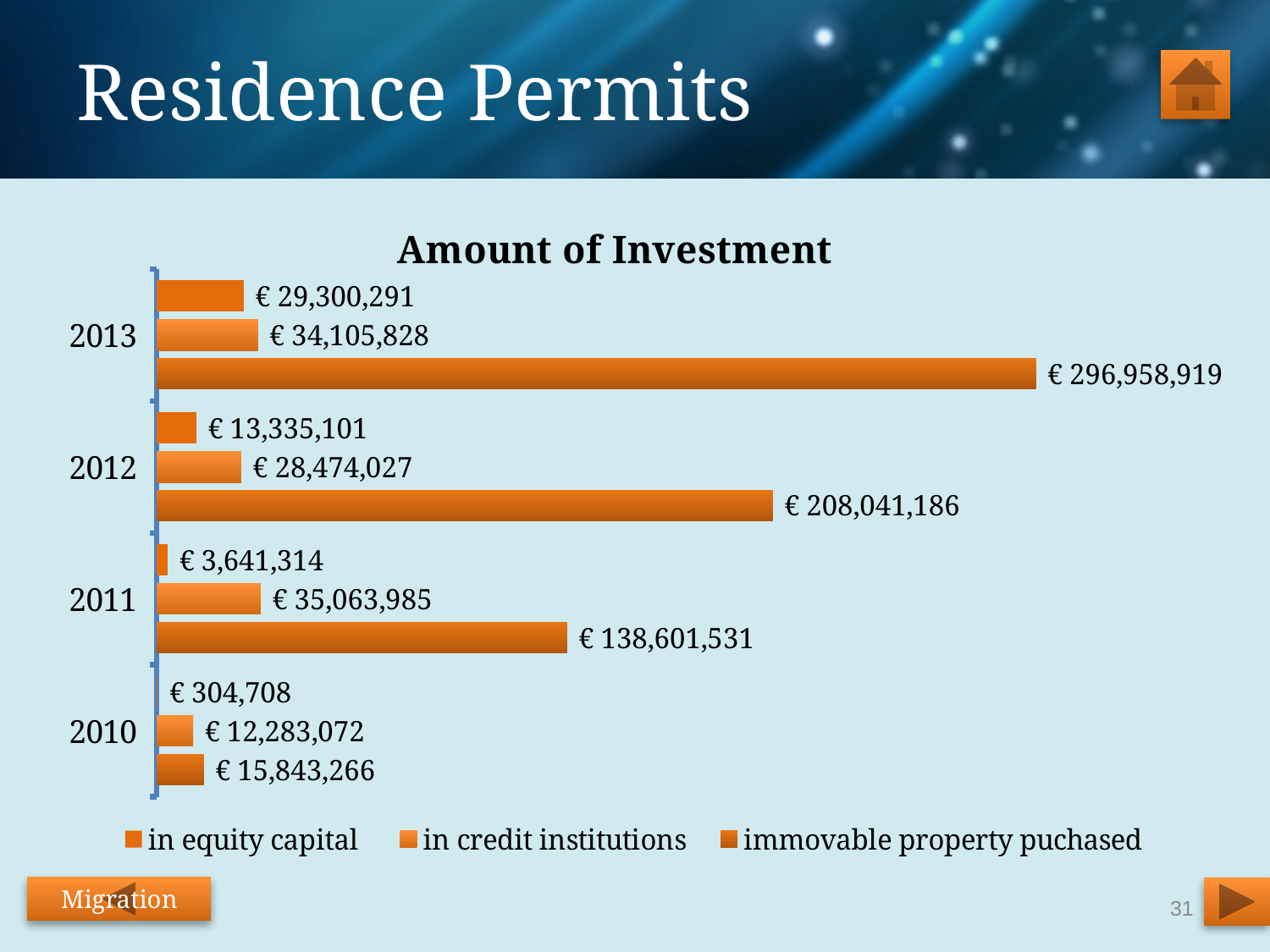
How many years are shown on the 'Amount of Investment' chart? 4 What is the value of the longest bar for 2011? € 138,601,531 What is the value of the shortest bar for 2010? € 304,708 What is the value of the middle bar for 2012? € 28,474,027 Which year contains the largest single value on the chart? 2013 What is the smallest value shown on the chart? € 304,708 Which is larger: the longest bar for 2012 or the longest bar for 2011? 2012 How many series does the legend of the 'Amount of Investment' chart list? 3 What kind of chart is shown under the title 'Amount of Investment'? bar chart What is the value of the longest bar for 2013? € 296,958,919 Does the longest bar in each year rise or fall from 2010 to 2013? rise What is the difference between the longest bar for 2013 and the longest bar for 2012? € 88,917,733